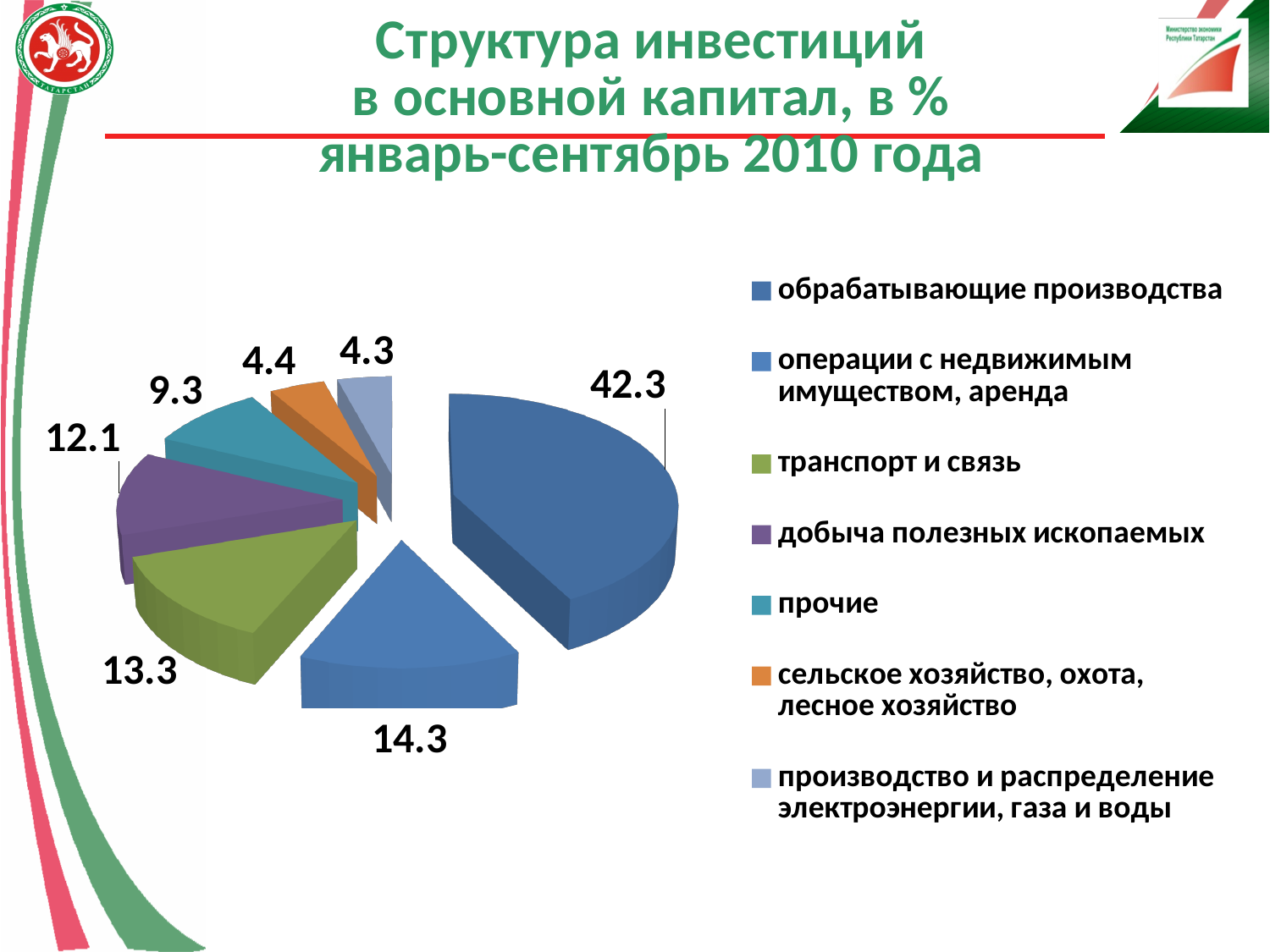
What is the value shown for прочие? 9.3 What is the value shown for сельское хозяйство, охота, лесное хозяйство? 4.4 What type of chart is shown on the slide? pie chart What is the title of the chart? Структура инвестиций в основной капитал, в % январь-сентябрь 2010 года What is the value shown for обрабатывающие производства? 42.3 Which category has the smallest share of the pie? производство и распределение электроэнергии, газа и воды Which is larger: транспорт и связь or добыча полезных ископаемых? транспорт и связь What is the value shown for добыча полезных ископаемых? 12.1 What is the value shown for транспорт и связь? 13.3 Which category has the largest share of the pie? обрабатывающие производства How many slices does the pie chart have? 7 What is the difference between the values for обрабатывающие производства and операции с недвижимым имуществом, аренда? 28.0